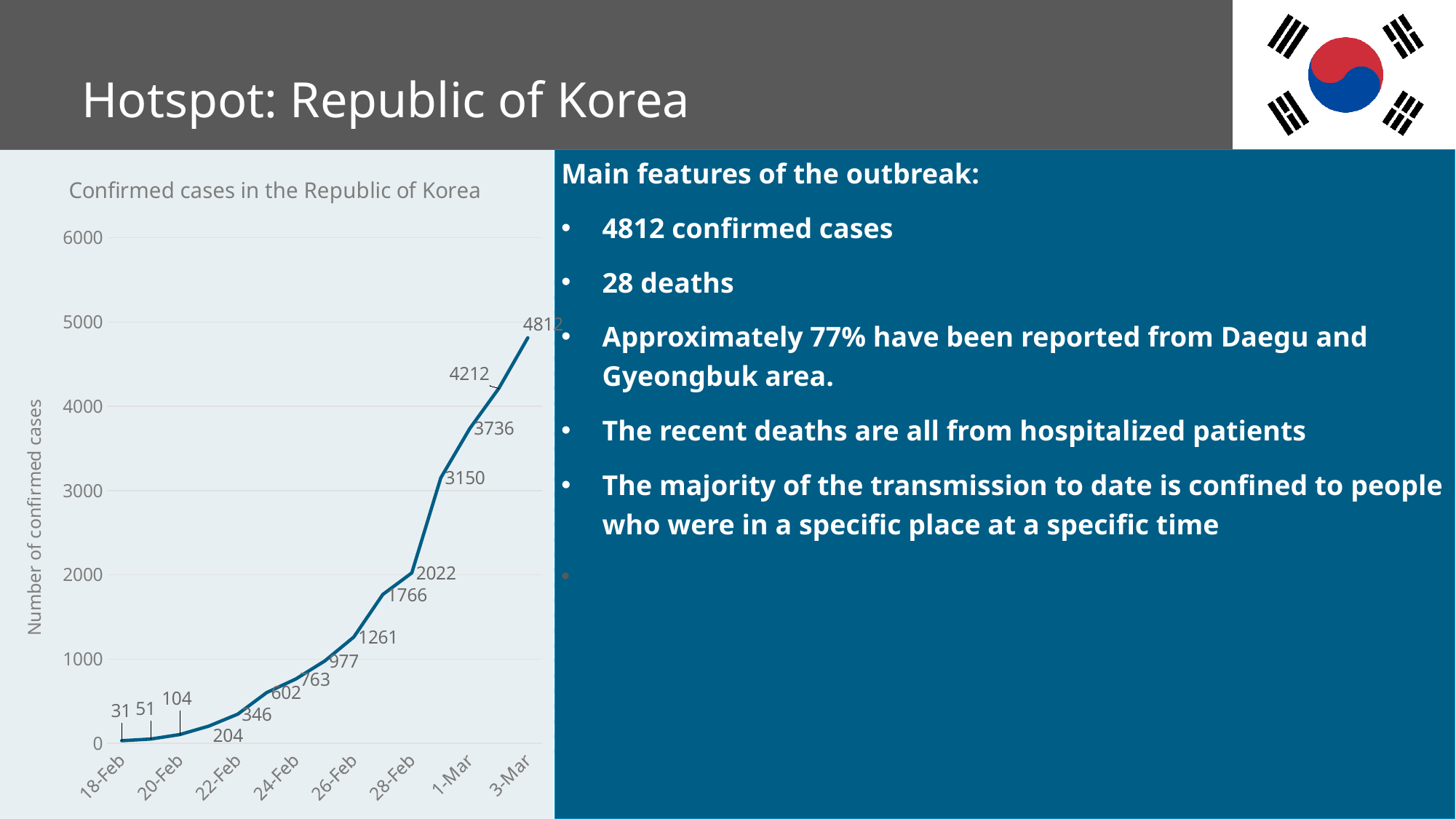
On which date is the number of confirmed cases lowest? 18-Feb On which date is the number of confirmed cases highest? 3-Mar Is the value for 1-Mar greater or less than 3000? greater Which date has more confirmed cases, 24-Feb or 26-Feb? 26-Feb How many data points are plotted on the line? 15 Do the confirmed cases rise or fall from 18-Feb to 3-Mar? rise What is the number of confirmed cases on 1-Mar? 3736 What is the number of confirmed cases on 28-Feb? 2022 What is the number of confirmed cases on 3-Mar? 4812 How many more confirmed cases were there on 3-Mar than on 1-Mar? 1076 What is the number of confirmed cases on 18-Feb? 31 What kind of chart is shown on the slide? line chart